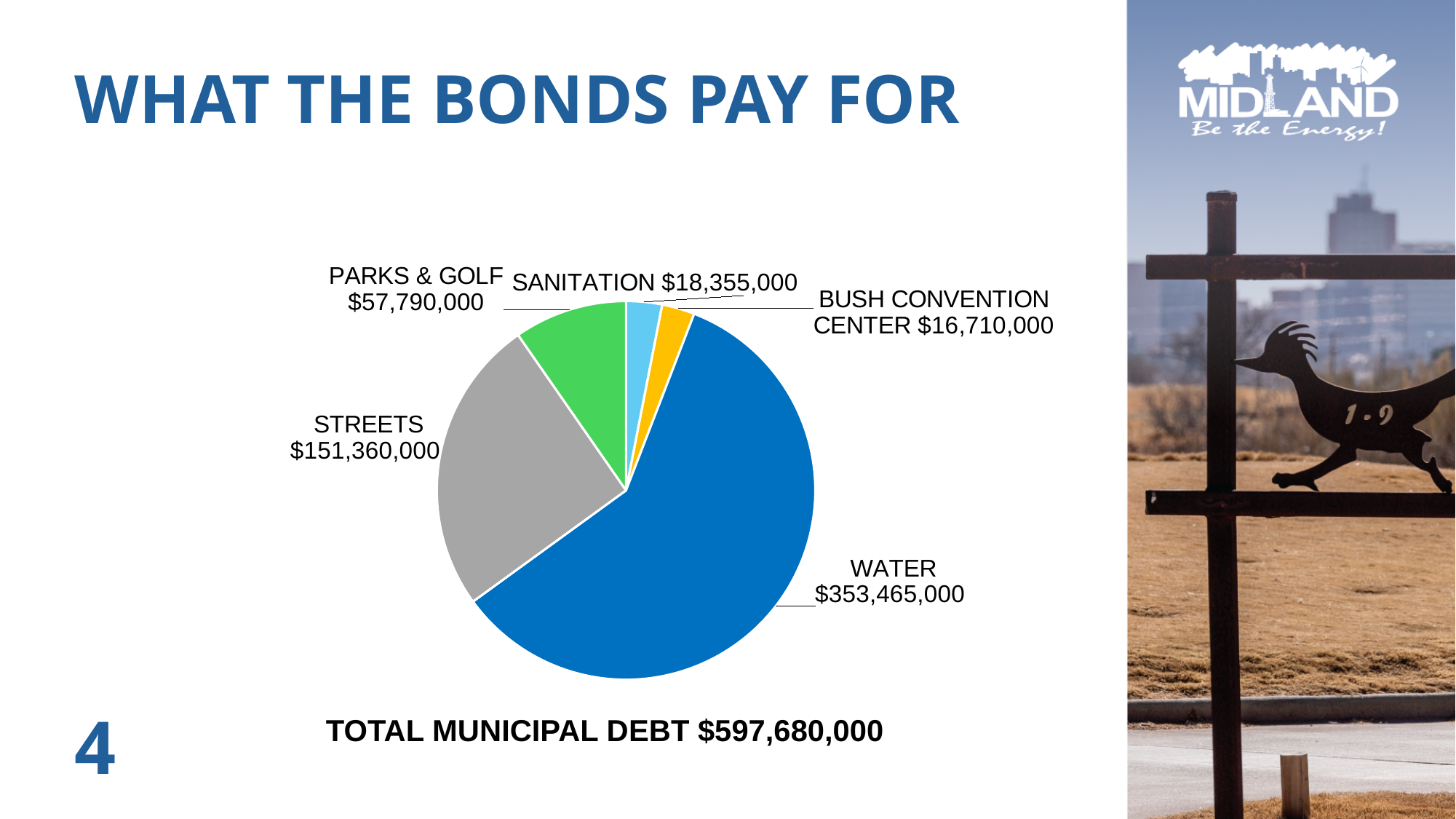
Which is larger, SANITATION or BUSH CONVENTION CENTER? SANITATION How many slices does the pie chart have? 5 Which category has the smallest slice of the pie? BUSH CONVENTION CENTER What is the value for BUSH CONVENTION CENTER? $16,710,000 What is the difference between the WATER and STREETS values? $202,105,000 What is the title of the slide containing the pie chart? WHAT THE BONDS PAY FOR Which category has the largest slice of the pie? WATER What is the value for WATER? $353,465,000 What is the total municipal debt shown below the chart? $597,680,000 What is the value for PARKS & GOLF? $57,790,000 What is the value for STREETS? $151,360,000 What kind of chart is shown on the slide? pie chart